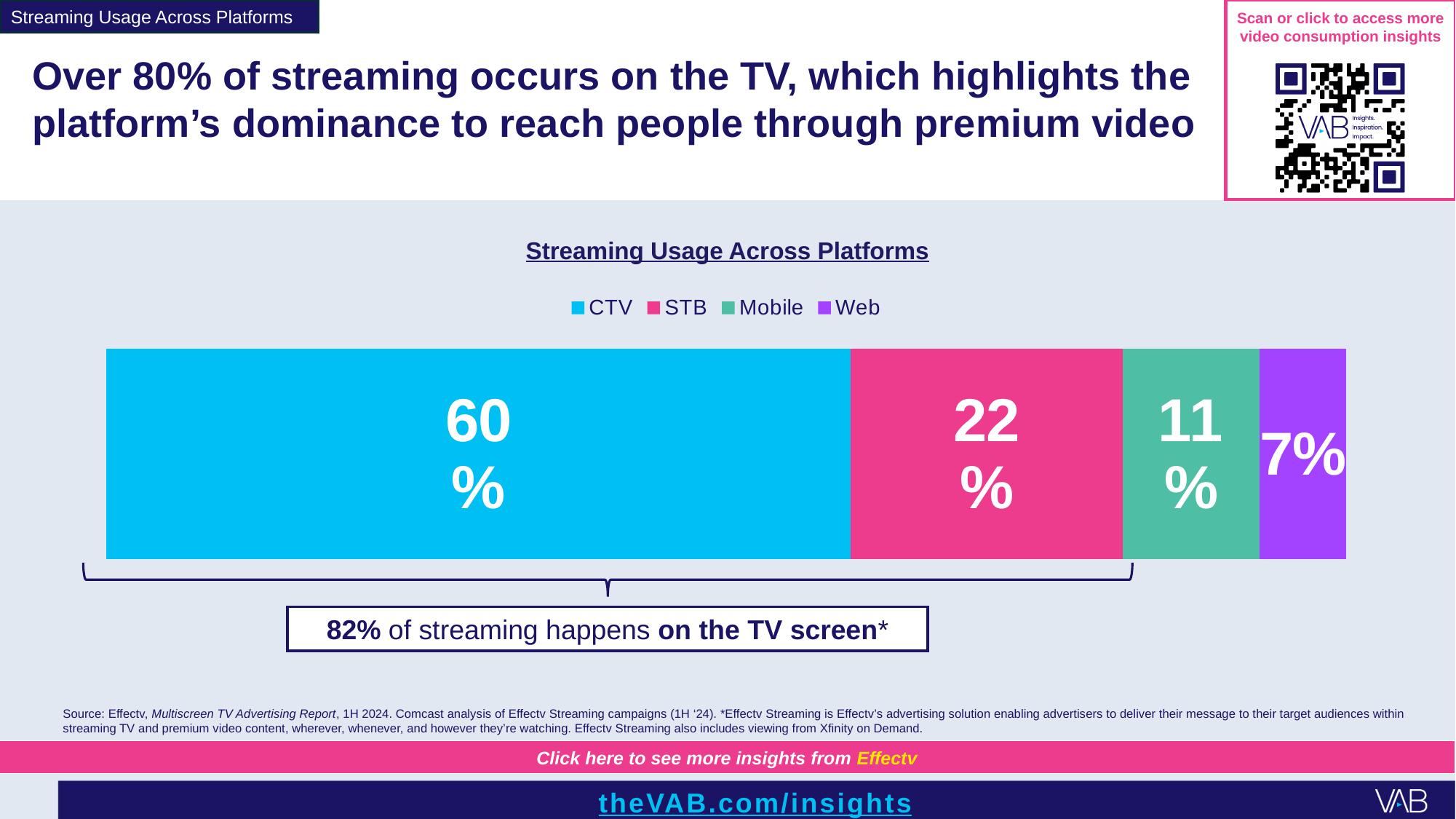
What is the value for Mobile? 11% What is the difference between the CTV and STB values? 38% What is the value for STB? 22% What is the value for CTV? 60% What is the combined value of CTV and STB? 82% Which platform has the highest share of streaming usage? CTV What is the value for Web? 7% What kind of chart is shown? Stacked bar chart Which platform has the lowest share of streaming usage? Web What is the title of the chart? Streaming Usage Across Platforms Which is larger, the value for Mobile or the value for Web? Mobile How many series does the legend list? 4